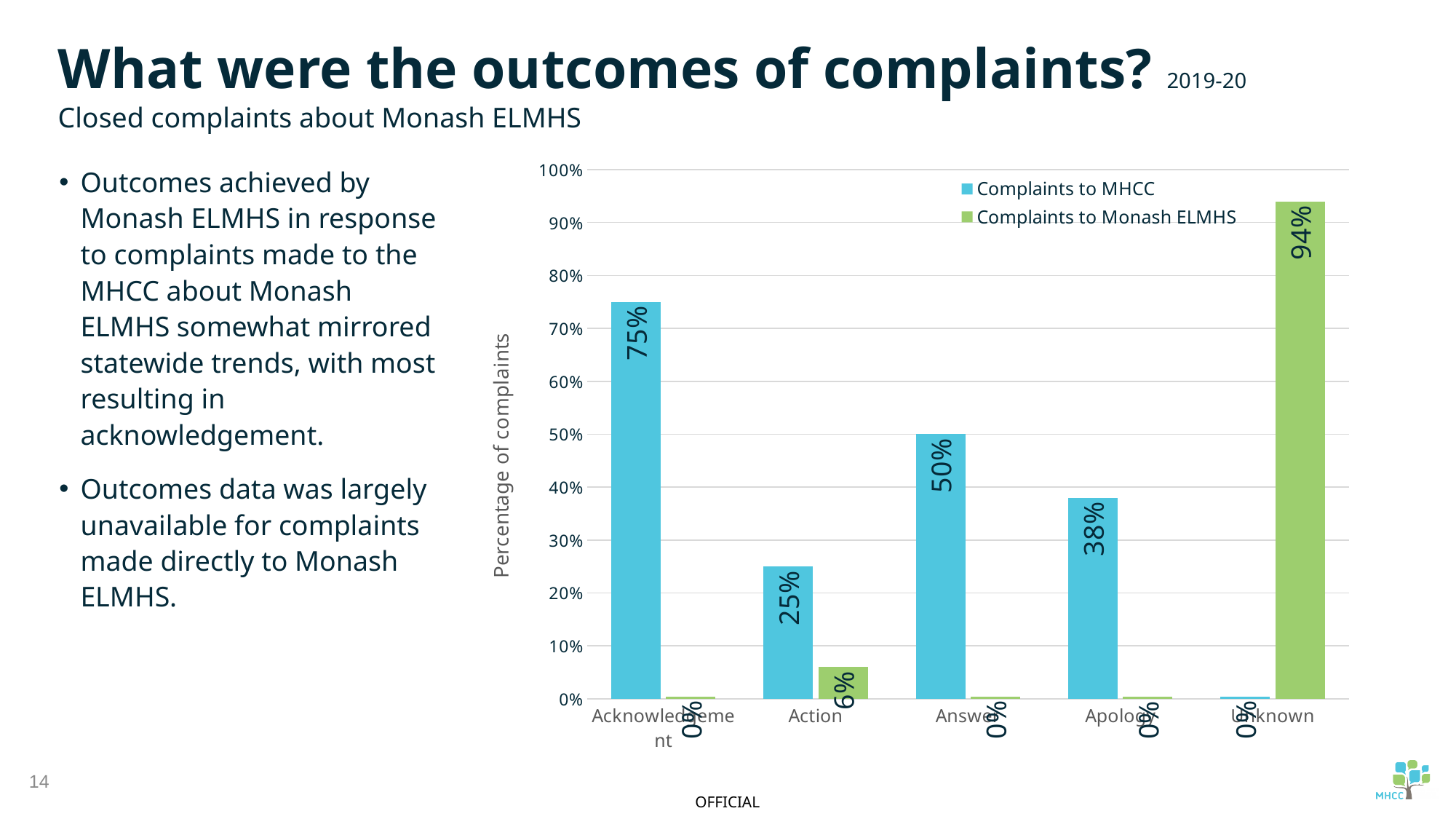
How many series does the legend list? 2 For Complaints to MHCC, which is larger: Action or Apology? Apology What percentage of complaints to MHCC resulted in an Apology? 38% What percentage of complaints to Monash ELMHS had an Unknown outcome? 94% Which outcome category has the highest value for Complaints to MHCC? Acknowledgement Which outcome category has the lowest value for Complaints to MHCC? Unknown How many outcome categories are shown on the x axis? 5 What is the label of the y axis? Percentage of complaints What is the difference between the Complaints to MHCC values for Acknowledgement and Answer? 25% What percentage of complaints to MHCC resulted in Acknowledgement? 75% What percentage of complaints to Monash ELMHS resulted in Action? 6% What kind of chart is shown on the slide? Bar chart